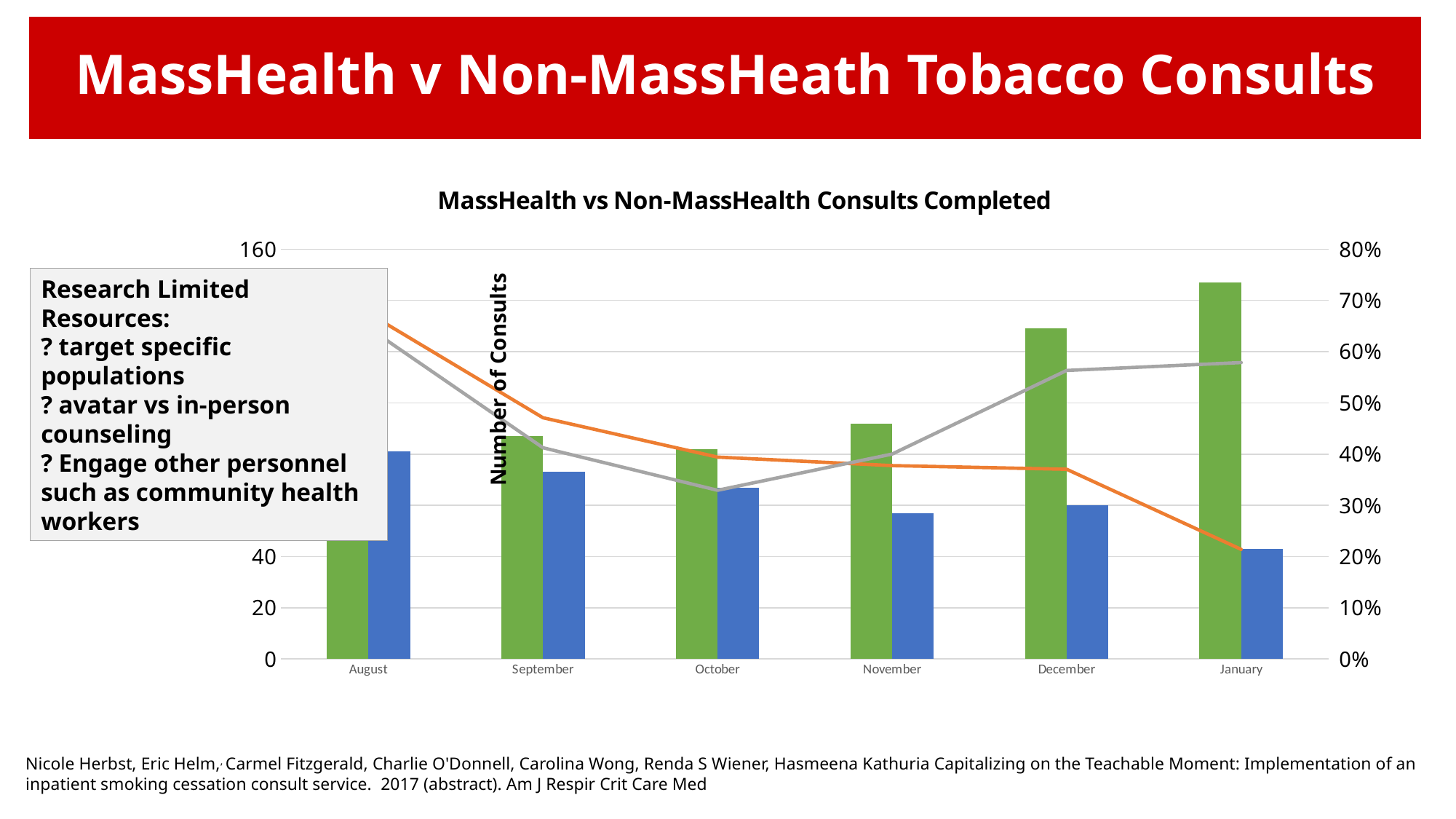
Is the green bar for January greater or less than 120 on the left axis? greater How many months are shown on the x axis of the chart? 6 What kind of chart is shown on the slide? A combined bar and line chart What is the label of the left vertical axis? Number of Consults Is the orange line's value for January greater or less than 30% on the right axis? less In which month is the blue bar the shortest? January What is the title of the chart? MassHealth vs Non-MassHealth Consults Completed In December, which bar is taller, the green bar or the blue bar? The green bar Is the blue bar for January greater or less than 60 on the left axis? less In which month is the green bar the tallest? January Does the orange line rise or fall from August to January? It falls